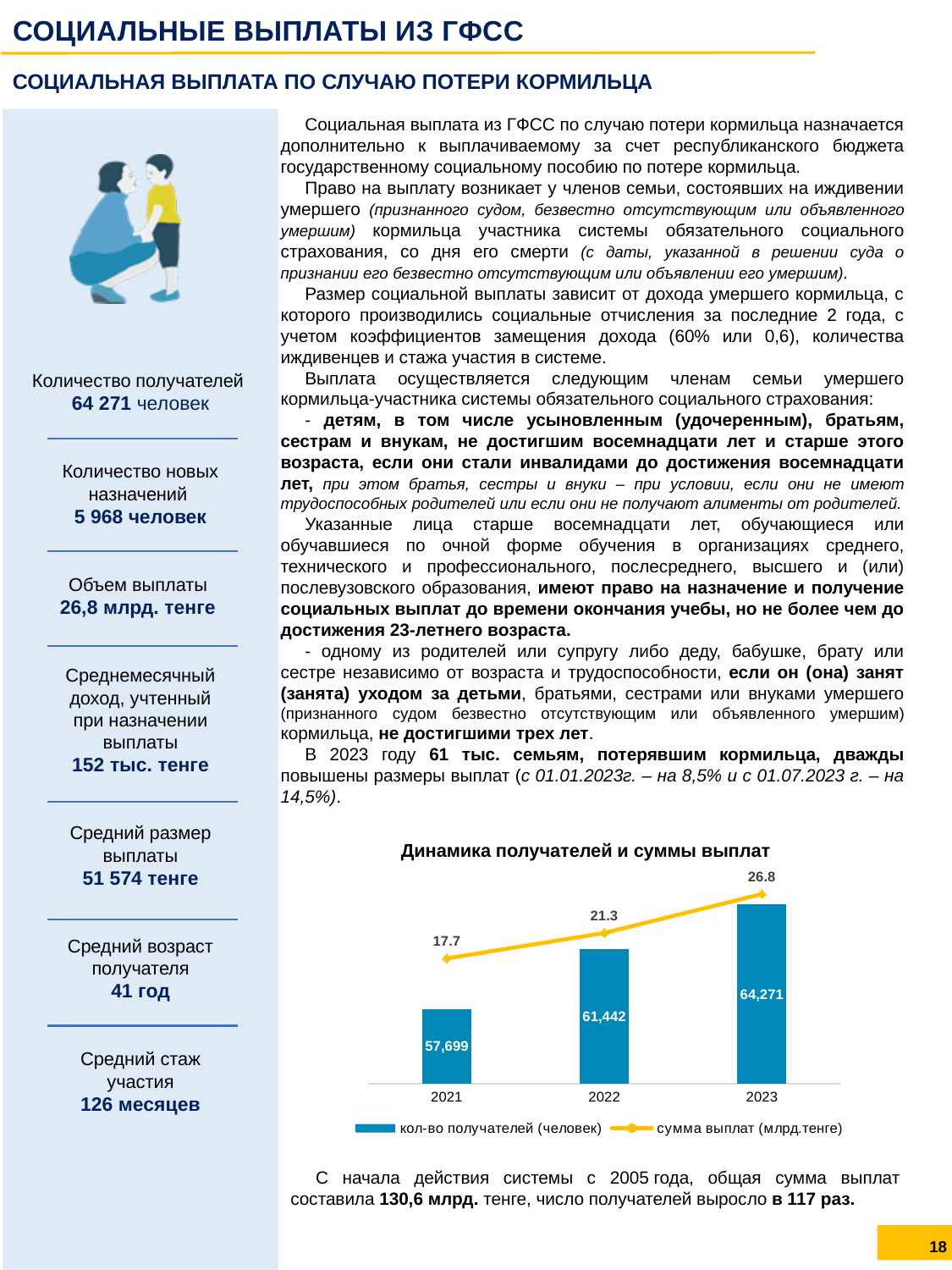
What is the title of the chart on the slide? Динамика получателей и суммы выплат In which year is the sum of payments (сумма выплат) the highest? 2023 How many series does the chart legend list? 2 What is the number of recipients (кол-во получателей) in 2023? 64,271 In which year is the number of recipients the lowest? 2021 How many years are shown on the x axis of the chart? 3 What is the sum of payments (сумма выплат, млрд.тенге) in 2022? 21.3 What is the number of recipients (кол-во получателей) in 2021? 57,699 What type of chart is shown on the slide? Combined bar and line chart By how much did the sum of payments (млрд.тенге) increase from 2021 to 2023? 9.1 What is the difference in the number of recipients between 2023 and 2022? 2,829 Does the number of recipients rise or fall from 2021 to 2023? Rise